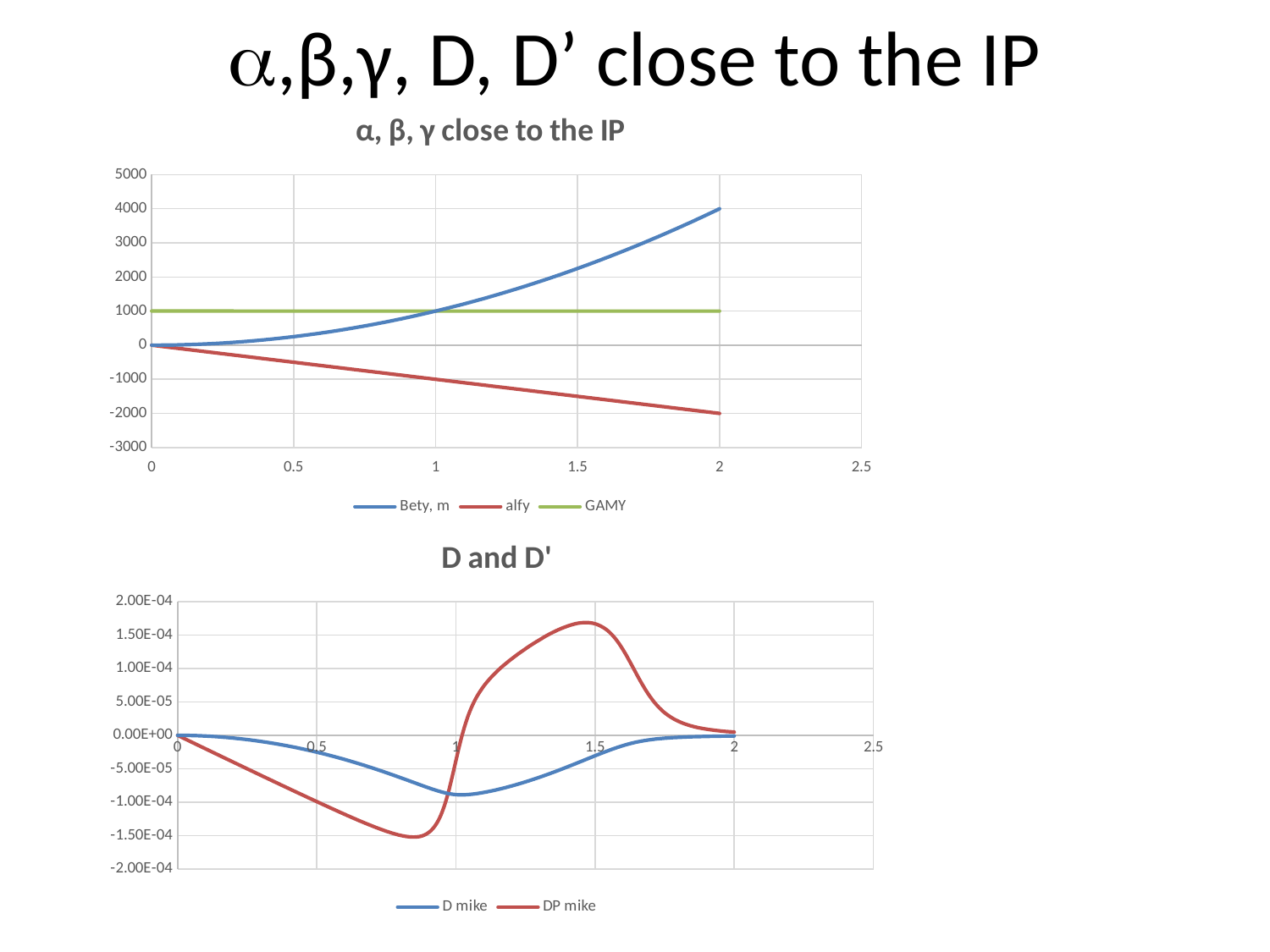
How many series does the legend of the "D and D'" chart list? 2 In the "α, β, γ close to the IP" chart, is the value of Bety, m at x = 2 greater or less than 3000? greater In the "α, β, γ close to the IP" chart, which series is plotted as a constant horizontal line? GAMY In the "D and D'" chart, which series reaches the lower minimum value, D mike or DP mike? DP mike In the "α, β, γ close to the IP" chart, is the value of alfy at x = 2 greater or less than -1000? less In the "α, β, γ close to the IP" chart, does the Bety, m series rise or fall as x increases? rise In the "D and D'" chart, is the peak value of DP mike greater or less than 1.50E-04? greater How many series does the legend of the "α, β, γ close to the IP" chart list? 3 In the "α, β, γ close to the IP" chart, does the alfy series rise or fall as x increases? fall In the "α, β, γ close to the IP" chart, which series has the highest value at x = 2? Bety, m In the "α, β, γ close to the IP" chart, which series has the lowest value at x = 2? alfy What type of chart is the "α, β, γ close to the IP" chart? line chart